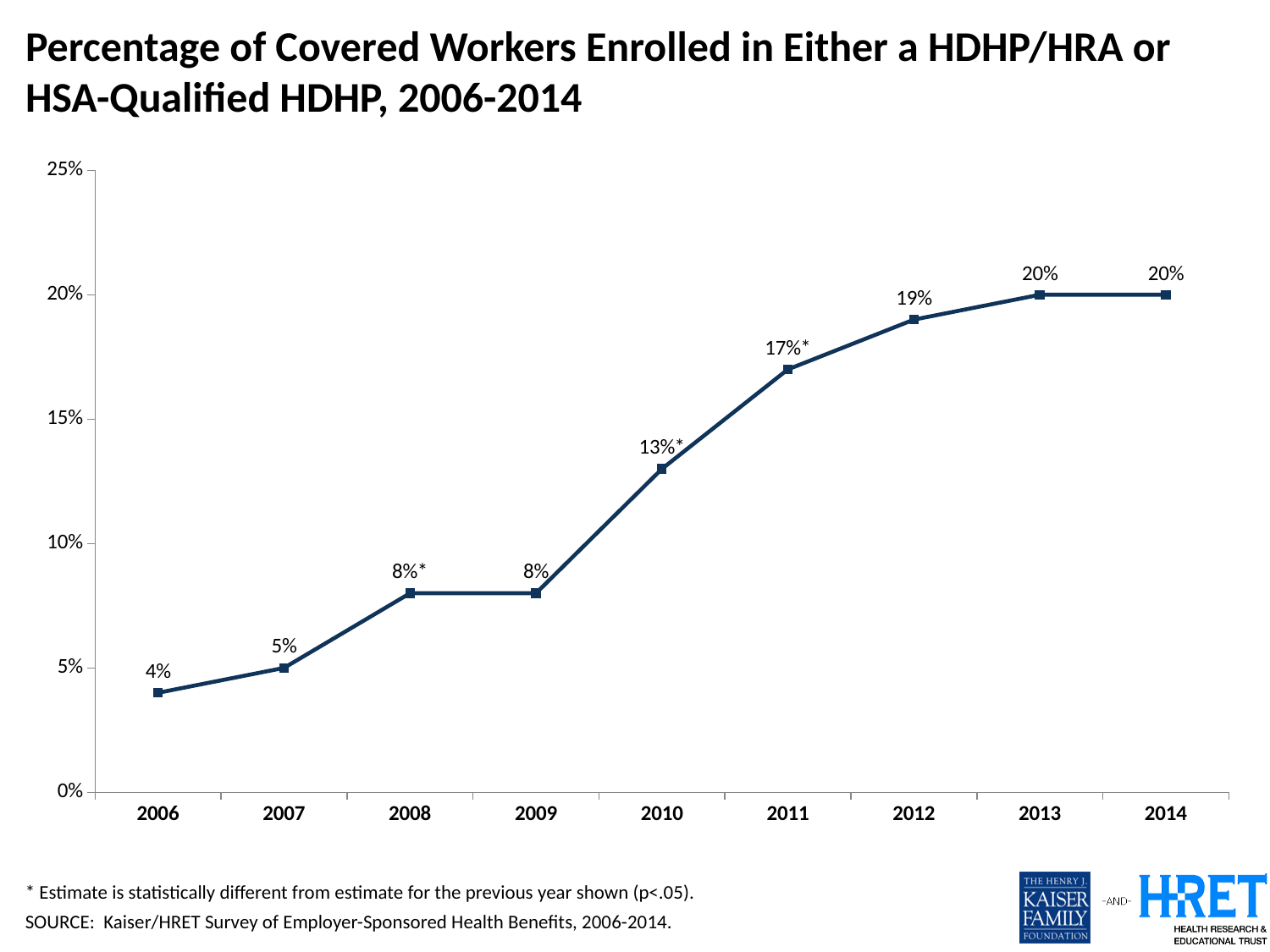
What kind of chart is shown on the slide? Line chart Is the value for 2011 greater or less than 15%? greater Do the values generally rise or fall from 2006 to 2014? Rise What is the difference between the values for 2011 and 2009? 9% Which year has the lowest percentage of covered workers enrolled? 2006 Which year has a larger value, 2007 or 2012? 2012 How many years are plotted on the x axis? 9 What is the highest value plotted on the chart? 20% According to the footnote, what does the asterisk next to a value indicate? Estimate is statistically different from estimate for the previous year shown (p<.05) What is the value shown for 2006? 4% What is the value shown for 2012? 19% What percentage of covered workers were enrolled in either a HDHP/HRA or HSA-qualified HDHP in 2010? 13%